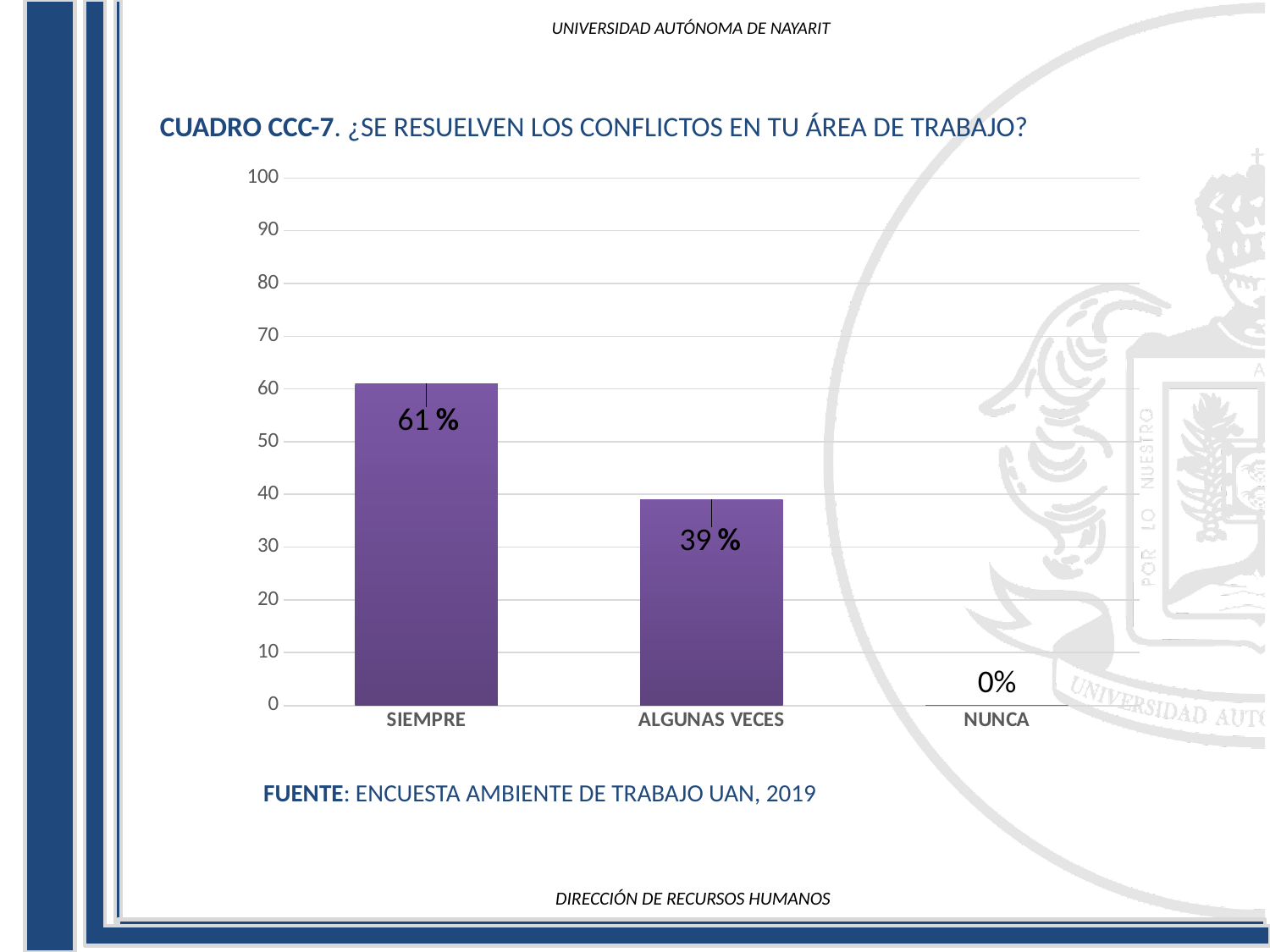
What is the value for NUNCA? 0% What is the source cited below the chart? ENCUESTA AMBIENTE DE TRABAJO UAN, 2019 How many categories are shown on the x axis? 3 What is the difference between the values for SIEMPRE and ALGUNAS VECES? 22 % Is the value for SIEMPRE greater or less than 50? greater Is the value for ALGUNAS VECES greater or less than 40? less What is the value for ALGUNAS VECES? 39 % Which is larger, the value for SIEMPRE or the value for ALGUNAS VECES? SIEMPRE Which category has the lowest value? NUNCA What is the value for SIEMPRE? 61 % What kind of chart is shown on the slide? Bar chart Which category has the highest value? SIEMPRE